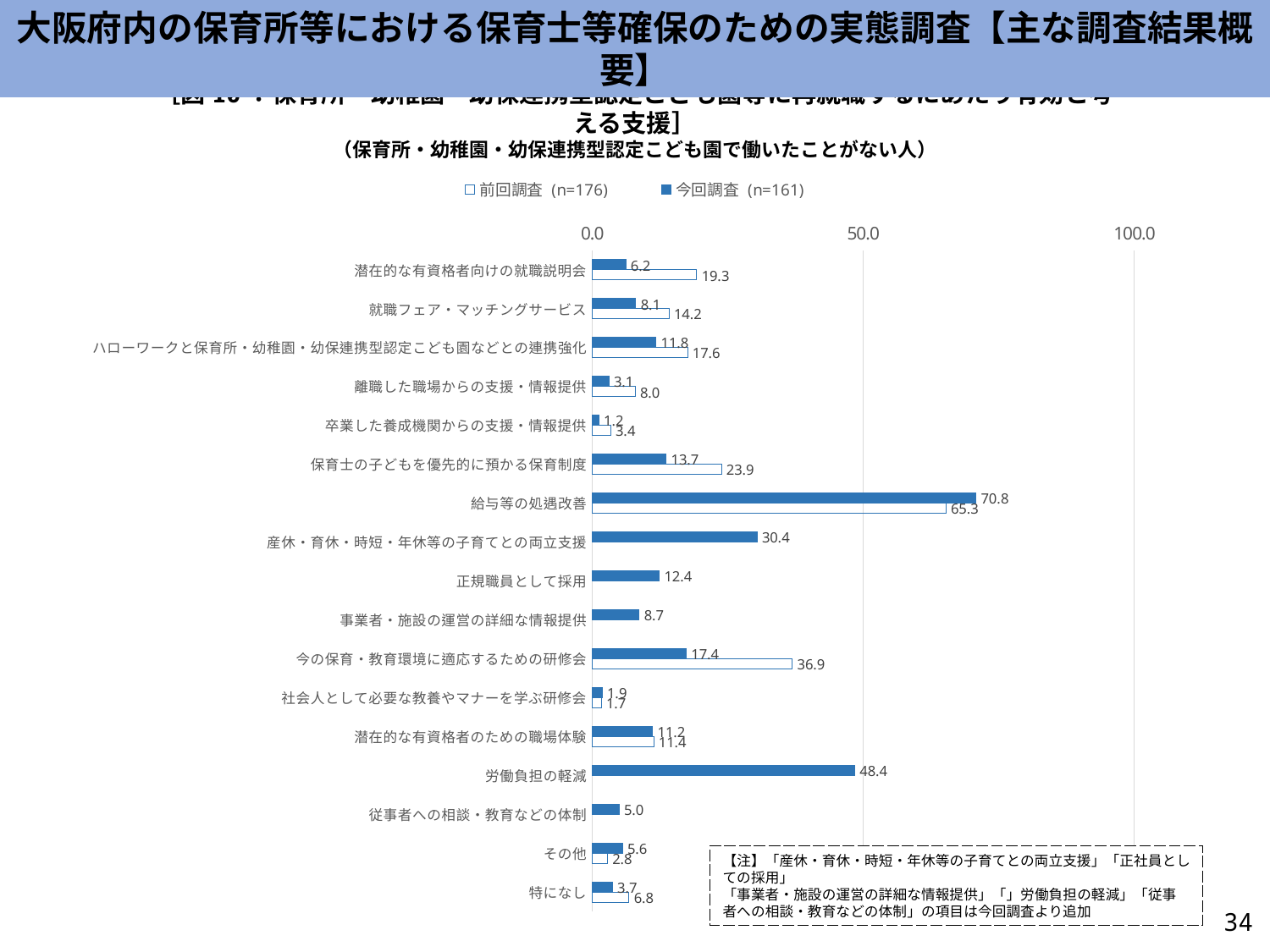
What is the value for 今の保育・教育環境に適応するための研修会 in the 前回調査 (n=176) series? 36.9 How many categories are shown on the chart? 17 What is the value for 労働負担の軽減 in the 今回調査 (n=161) series? 48.4 What is the sample size (n) shown in the legend for 今回調査? 161 Is the 今回調査 value for 産休・育休・時短・年休等の子育てとの両立支援 greater or less than 50.0? less Which category has the lowest value in the 今回調査 (n=161) series? 卒業した養成機関からの支援・情報提供 For 保育士の子どもを優先的に預かる保育制度, which series has the larger value, 前回調査 or 今回調査? 前回調査 What is the value for 給与等の処遇改善 in the 今回調査 (n=161) series? 70.8 What kind of chart is shown on the slide? bar chart Which category has the highest value in the 今回調査 (n=161) series? 給与等の処遇改善 What is the difference between the 前回調査 and 今回調査 values for 潜在的な有資格者向けの就職説明会? 13.1 How many series does the legend list? 2